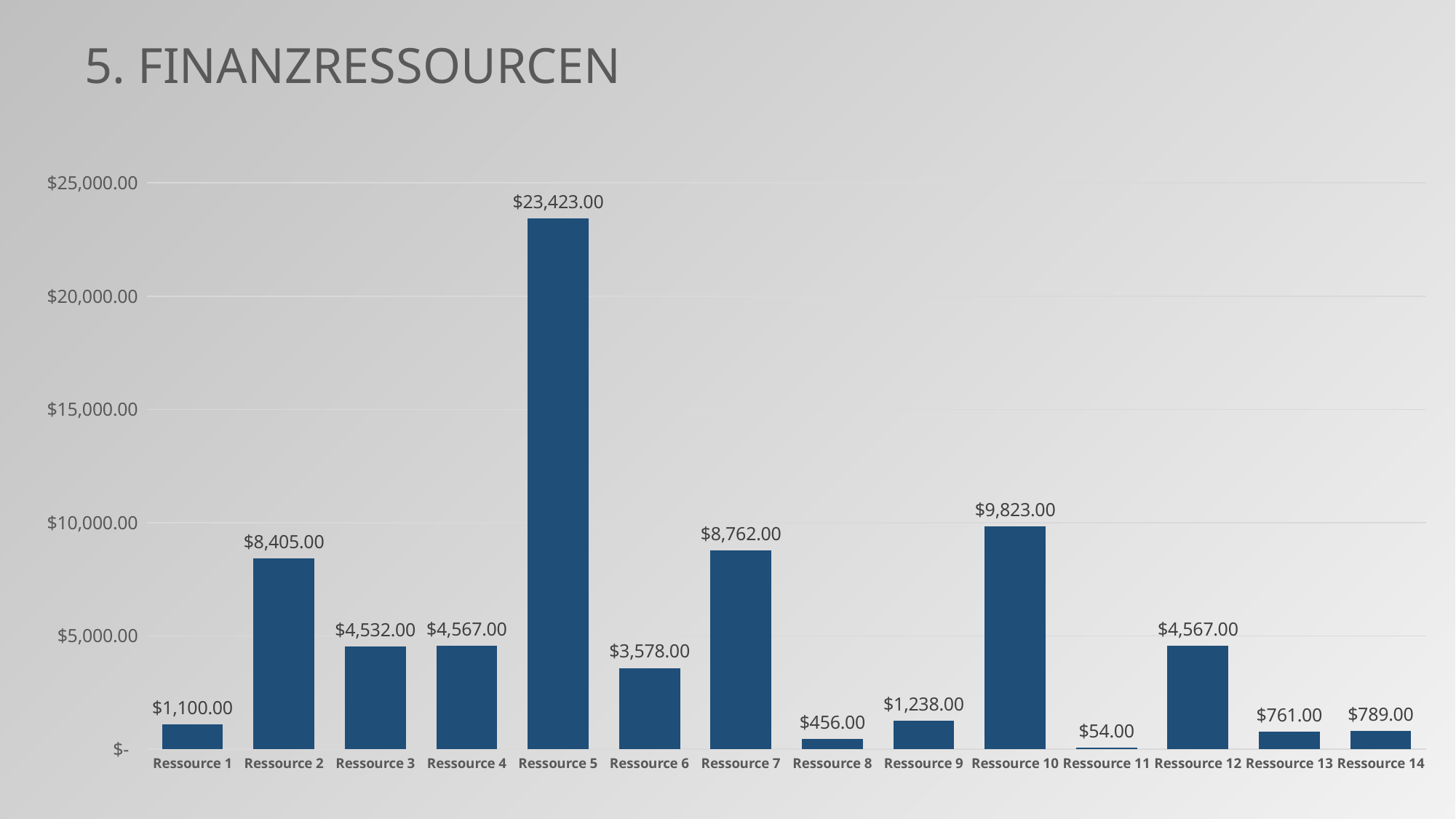
Is the value for Ressource 10 greater or less than $5,000.00? greater What is the value for Ressource 9? $1,238.00 Which is larger, the value for Ressource 13 or the value for Ressource 14? Ressource 14 What is the value for Ressource 5? $23,423.00 Which category has the highest value? Ressource 5 What is the difference between the values for Ressource 2 and Ressource 6? $4,827.00 Which category has the lowest value? Ressource 11 How many categories are shown on the x axis? 14 What is the title of the slide? 5. FINANZRESSOURCEN What kind of chart is shown on the slide? bar chart What is the difference between the values for Ressource 10 and Ressource 7? $1,061.00 What is the value for Ressource 11? $54.00